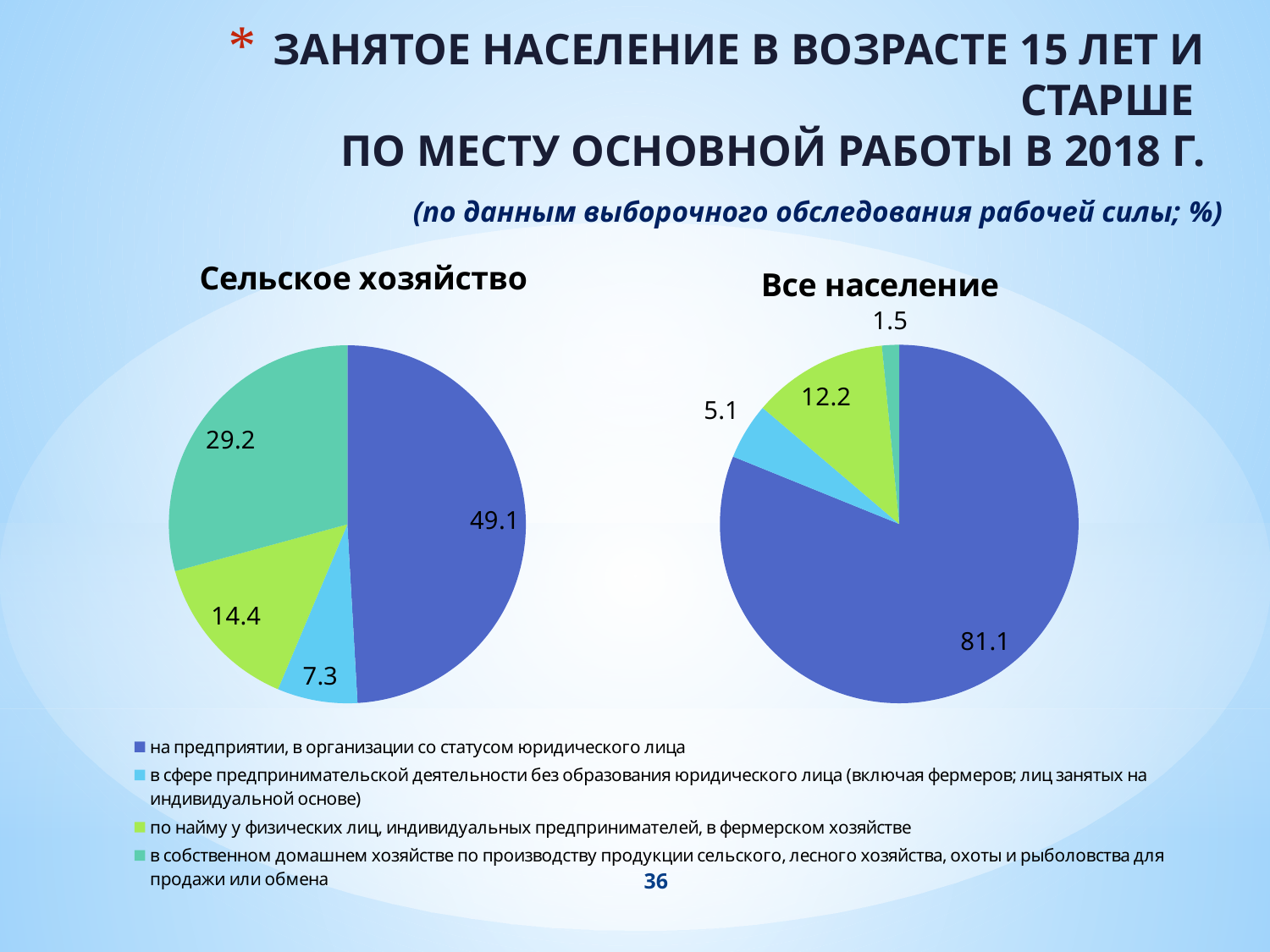
In the "Сельское хозяйство" chart, what is the value for "на предприятии, в организации со статусом юридического лица"? 49.1 How many entries does the legend list? 4 In the "Все население" chart, what is the value for "по найму у физических лиц, индивидуальных предпринимателей, в фермерском хозяйстве"? 12.2 In the "Все население" chart, which category has the largest slice? на предприятии, в организации со статусом юридического лица What colour is the slice labelled 7.3 in the "Сельское хозяйство" chart? light blue In the "Все население" chart, what is the value for "в собственном домашнем хозяйстве по производству продукции сельского, лесного хозяйства, охоты и рыболовства для продажи или обмена"? 1.5 How many slices does the "Все население" pie chart have? 4 In the "Сельское хозяйство" chart, which category has the smallest slice? в сфере предпринимательской деятельности без образования юридического лица (включая фермеров; лиц занятых на индивидуальной основе) In the "Сельское хозяйство" chart, what is the difference between the values 29.2 and 14.4? 14.8 What kind of chart is the "Сельское хозяйство" chart? pie chart Which is larger: the "в сфере предпринимательской деятельности без образования юридического лица" slice in the "Сельское хозяйство" chart or in the "Все население" chart? Сельское хозяйство What is the difference between the "на предприятии, в организации со статусом юридического лица" values in the "Все население" chart and the "Сельское хозяйство" chart? 32.0